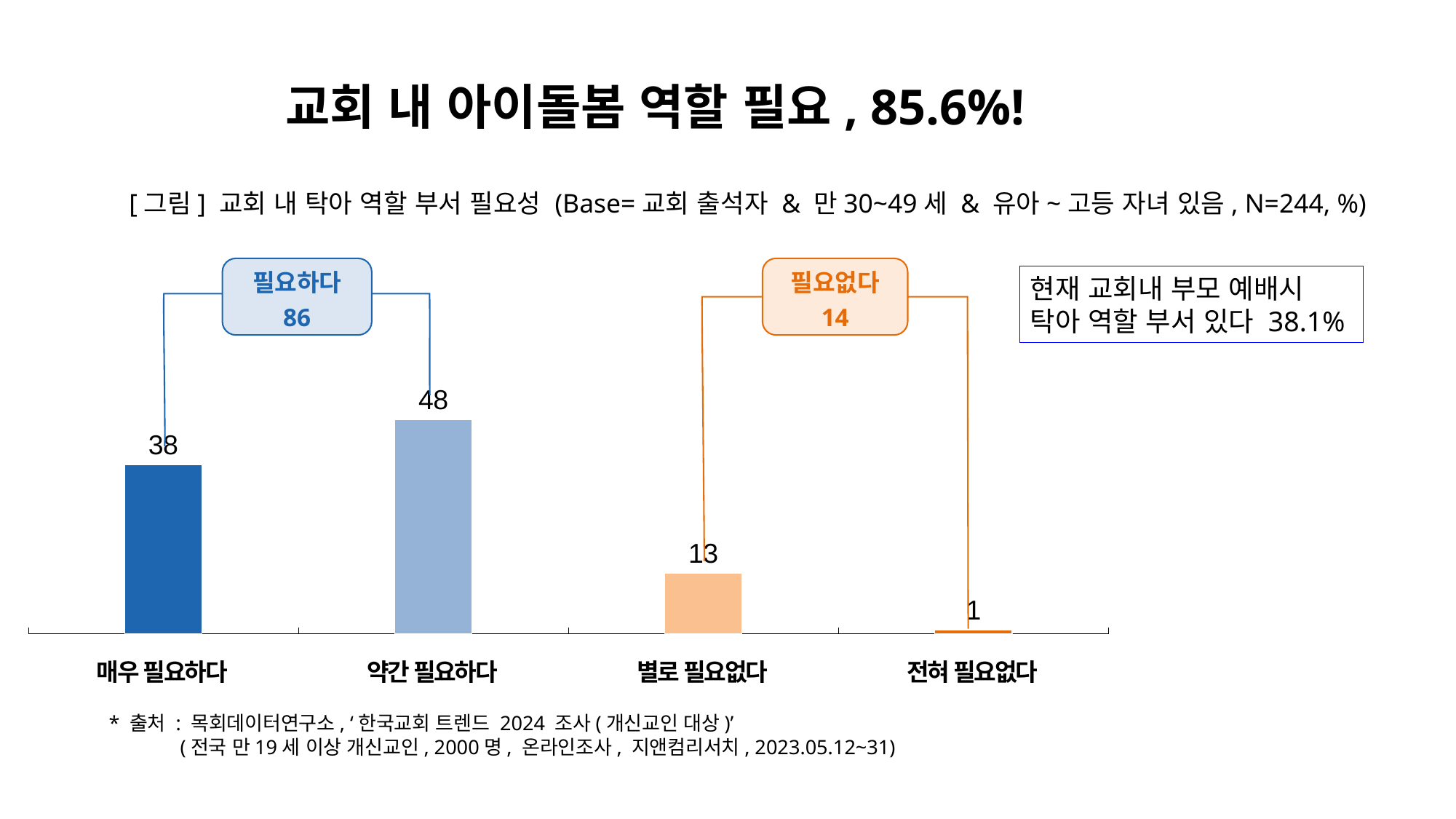
Which category has the highest value? 약간 필요하다 What combined value is shown in the 필요없다 callout box? 14 Which is larger, the value for 매우 필요하다 or the value for 별로 필요없다? 매우 필요하다 What is the value for 약간 필요하다? 48 What is the difference between the values for 약간 필요하다 and 매우 필요하다? 10 What combined value is shown in the 필요하다 callout box? 86 What is the value for 별로 필요없다? 13 What is the value for 전혀 필요없다? 1 What kind of chart is shown on the slide? bar chart Which category has the lowest value? 전혀 필요없다 What is the value for 매우 필요하다? 38 How many categories are shown on the x axis? 4